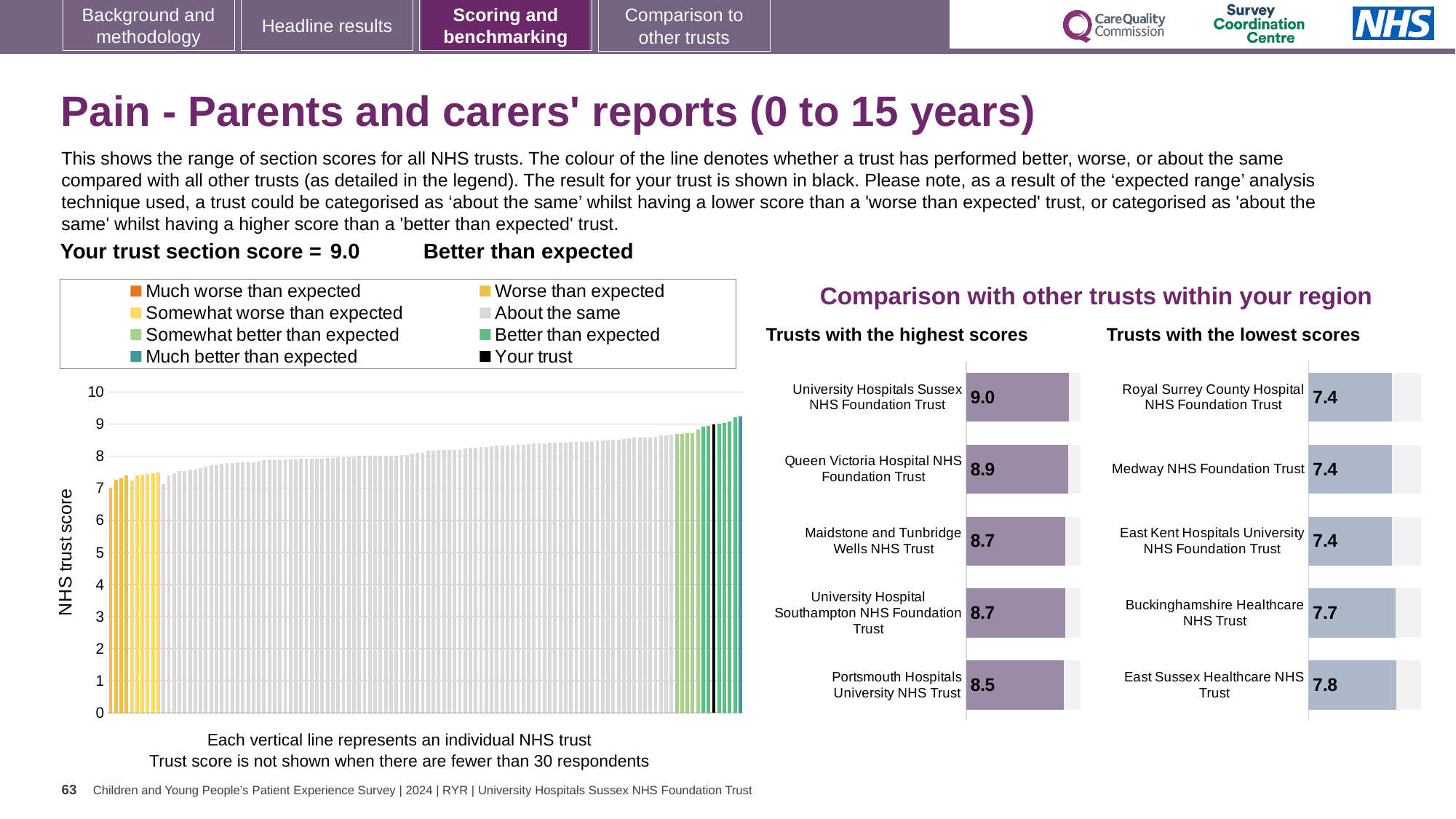
What is your trust's section score shown on the slide? 9.0 In the 'Trusts with the highest scores' chart, what is the score for Queen Victoria Hospital NHS Foundation Trust? 8.9 How many trusts are shown in the 'Trusts with the highest scores' chart? 5 In the 'Trusts with the highest scores' chart, what is the difference between the scores of University Hospitals Sussex NHS Foundation Trust and Portsmouth Hospitals University NHS Trust? 0.5 What kind of chart is the large chart on the left showing all NHS trusts? Bar chart In the 'Trusts with the lowest scores' chart, what is the difference between the scores of East Sussex Healthcare NHS Trust and Royal Surrey County Hospital NHS Foundation Trust? 0.4 In the 'Trusts with the lowest scores' chart, which has the larger score: Buckinghamshire Healthcare NHS Trust or East Sussex Healthcare NHS Trust? East Sussex Healthcare NHS Trust What is the label on the vertical axis of the left-hand chart? NHS trust score How many entries does the legend above the left-hand chart list? 8 In the 'Trusts with the lowest scores' chart, which trust has the highest score? East Sussex Healthcare NHS Trust In the 'Trusts with the lowest scores' chart, what is the score for Buckinghamshire Healthcare NHS Trust? 7.7 In the 'Trusts with the highest scores' chart, which trust has the highest score? University Hospitals Sussex NHS Foundation Trust